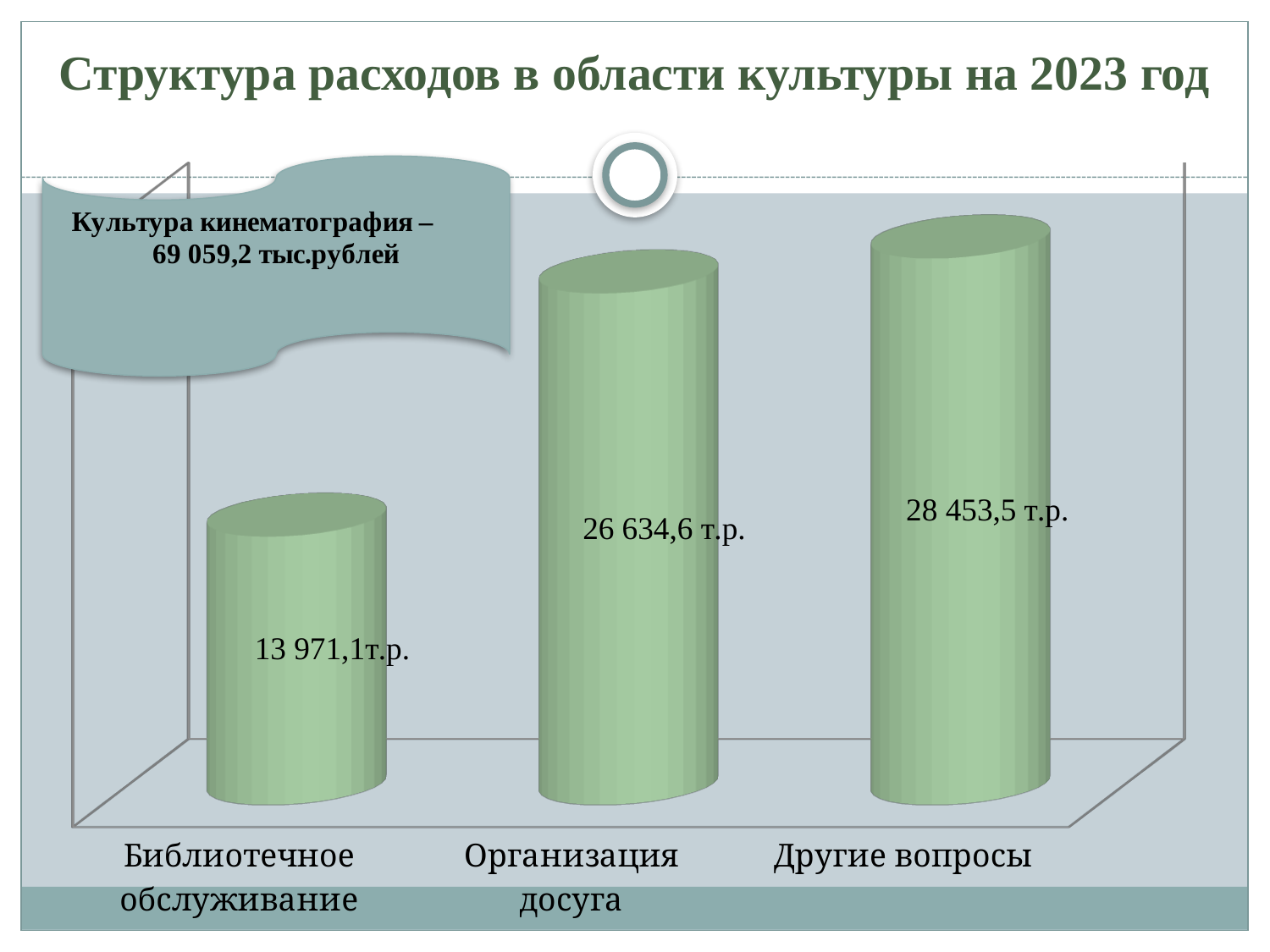
What is the value for Другие вопросы? 28 453,5 т.р. Which category has the highest value? Другие вопросы How many categories are shown in the chart? 3 What is the value for Организация досуга? 26 634,6 т.р. What is the value for Библиотечное обслуживание? 13 971,1т.р. What is the difference between the values for Другие вопросы and Организация досуга? 1 818,9 т.р. What kind of chart is shown on the slide? Bar chart Which is larger, the value for Организация досуга or the value for Библиотечное обслуживание? Организация досуга What is the difference between the values for Организация досуга and Библиотечное обслуживание? 12 663,5 т.р. Do the values rise or fall from left to right across the categories? Rise What is the title of the slide? Структура расходов в области культуры на 2023 год Which category has the lowest value? Библиотечное обслуживание